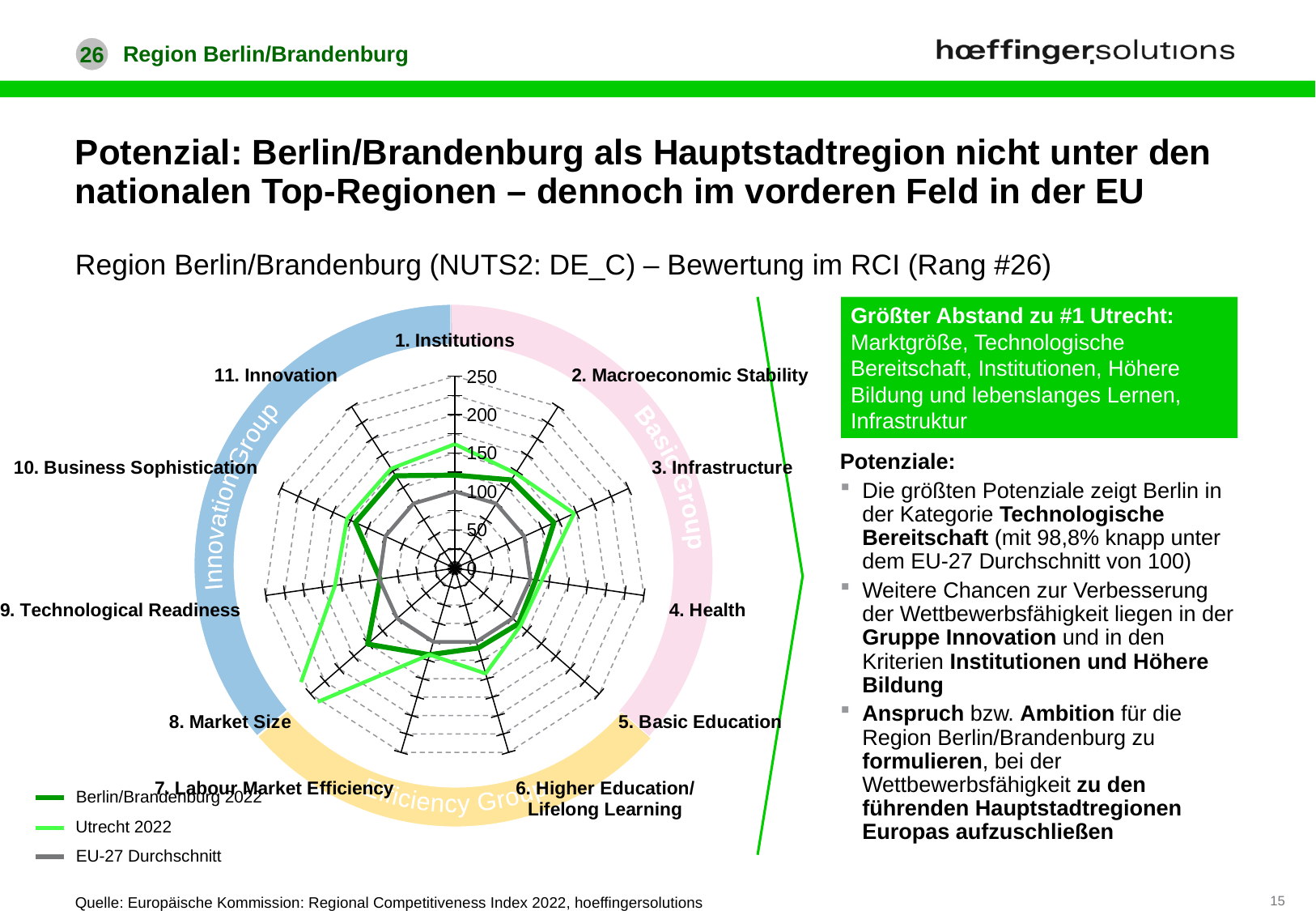
Is the Berlin/Brandenburg 2022 value for 3. Infrastructure greater or less than 100? greater Is the Utrecht 2022 value for 8. Market Size greater or less than 150? greater For 9. Technological Readiness, which series has the larger value: Berlin/Brandenburg 2022 or Utrecht 2022? Utrecht 2022 Is the Berlin/Brandenburg 2022 value for 9. Technological Readiness greater or less than 150? less How many categories (axes) does the radar chart have? 11 For 8. Market Size, which series has the larger value: Berlin/Brandenburg 2022 or Utrecht 2022? Utrecht 2022 How many series does the chart legend list? 3 What kind of chart is shown on the slide? Radar chart Which series are listed in the chart legend? Berlin/Brandenburg 2022, Utrecht 2022, EU-27 Durchschnitt For which category does the Utrecht 2022 series reach its highest value? 8. Market Size What is the highest value shown on the chart's radial axis? 250